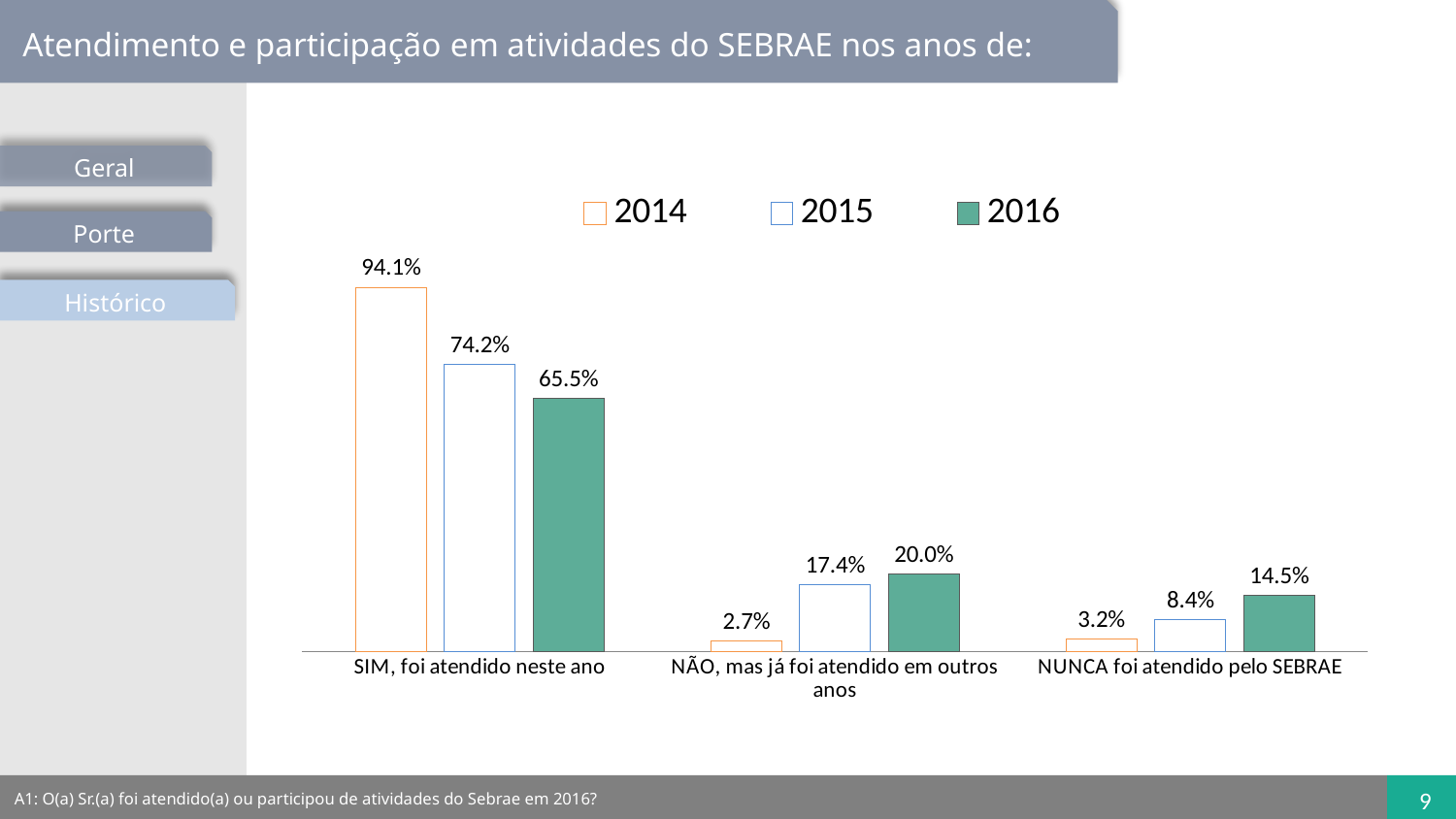
Which year has the lowest value in the category "NUNCA foi atendido pelo SEBRAE"? 2014 Which year has the highest value in the category "SIM, foi atendido neste ano"? 2014 What kind of chart is shown on the slide? bar chart What is the value for 2015 in the category "NÃO, mas já foi atendido em outros anos"? 17.4% Which is larger: the 2016 value for "NÃO, mas já foi atendido em outros anos" or the 2016 value for "NUNCA foi atendido pelo SEBRAE"? NÃO, mas já foi atendido em outros anos What is the difference between the 2014 and 2016 values in the category "SIM, foi atendido neste ano"? 28.6% How many series does the legend list? 3 Which series is shown with solid green bars? 2016 What is the value for 2016 in the category "NUNCA foi atendido pelo SEBRAE"? 14.5% How many categories are shown on the x axis? 3 What is the value for 2014 in the category "SIM, foi atendido neste ano"? 94.1% Do the values for "SIM, foi atendido neste ano" rise or fall from 2014 to 2016? fall